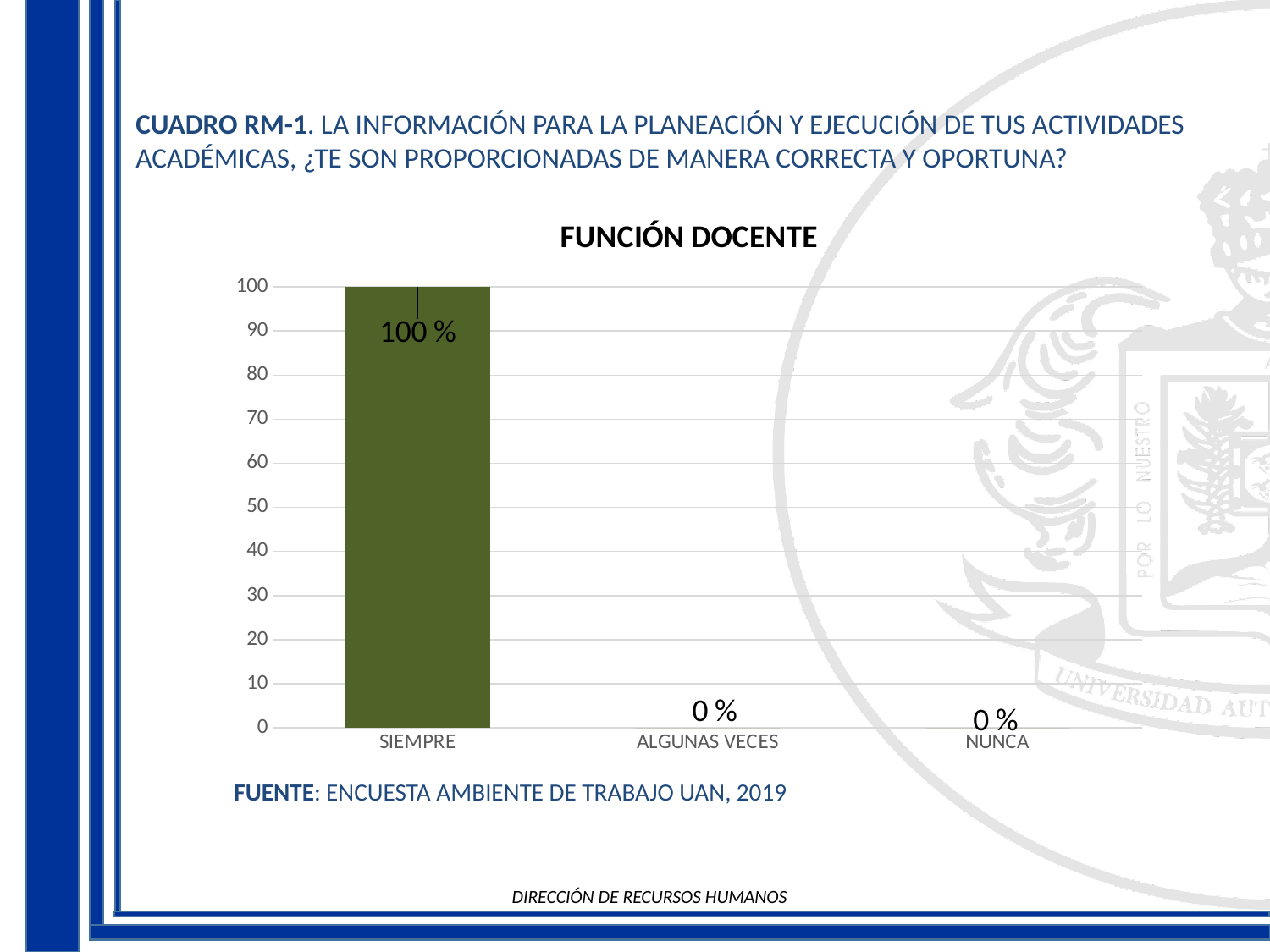
What is the title of the chart? FUNCIÓN DOCENTE Which category has the highest value? SIEMPRE What is the value for SIEMPRE? 100 % What is the maximum value shown on the y axis? 100 What is the value for NUNCA? 0 % Do the values rise or fall from SIEMPRE to NUNCA along the x axis? fall What is the value for ALGUNAS VECES? 0 % Which is larger, the value for SIEMPRE or the value for ALGUNAS VECES? SIEMPRE Is the value for SIEMPRE greater or less than 50? greater What kind of chart is shown on the slide? bar chart What is the difference between the values for SIEMPRE and NUNCA? 100 % How many categories are shown on the x axis? 3